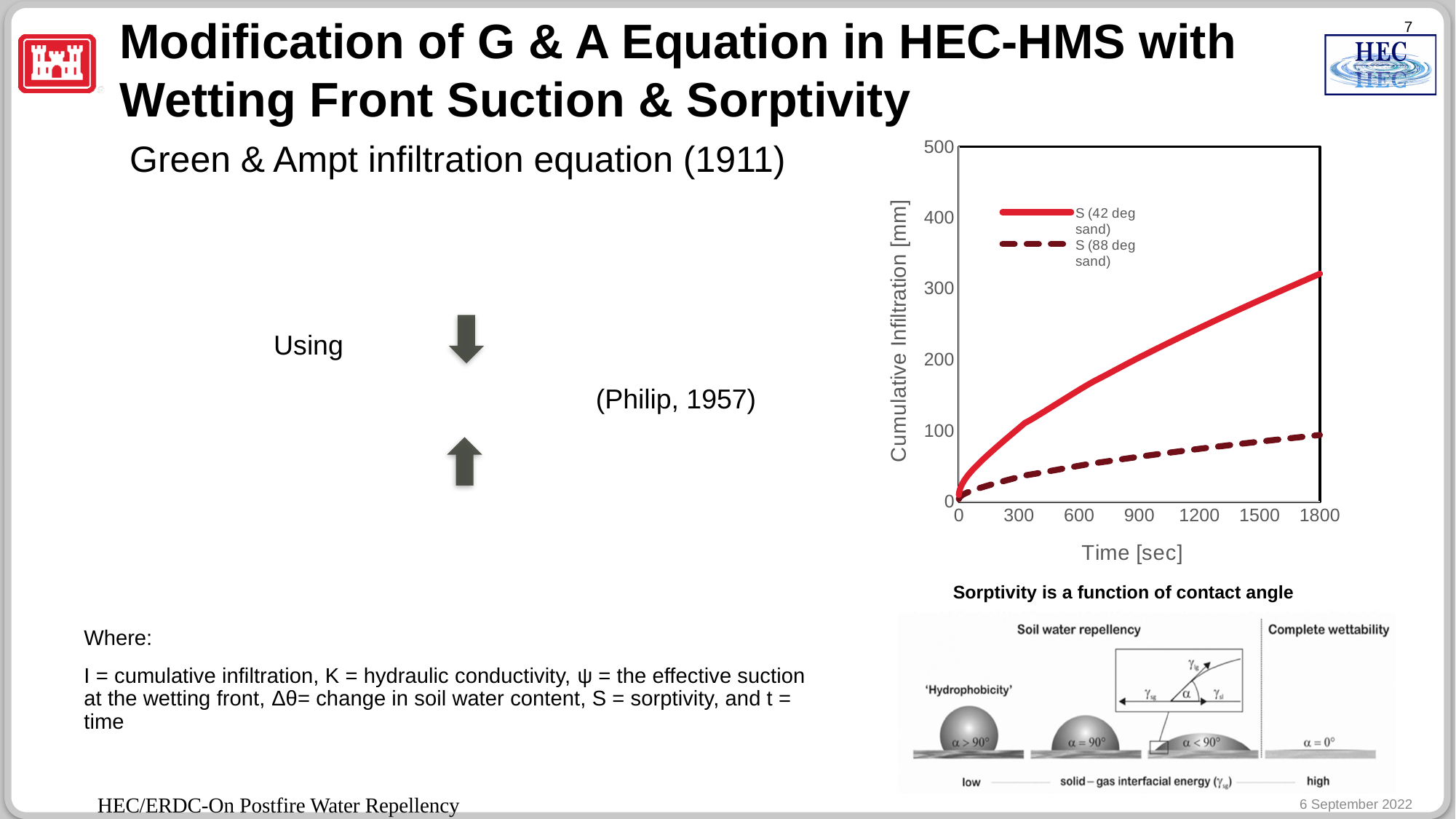
Which series has the lower cumulative infiltration throughout the chart? S (88 deg sand) Which series reaches the higher cumulative infiltration at 1800 seconds? S (42 deg sand) Is the cumulative infiltration for S (88 deg sand) at 900 seconds greater or less than 100? less Is the cumulative infiltration for S (42 deg sand) at 1800 seconds greater or less than 300? greater How many series does the chart legend list? 2 What is the label of the chart's x axis? Time [sec] Is the cumulative infiltration for S (88 deg sand) at 1800 seconds greater or less than 100? less What is the label of the chart's y axis? Cumulative Infiltration [mm] Does the cumulative infiltration for S (42 deg sand) rise or fall as time increases? rise What kind of chart is shown on the slide? line chart Does the cumulative infiltration for S (88 deg sand) rise or fall as time increases? rise